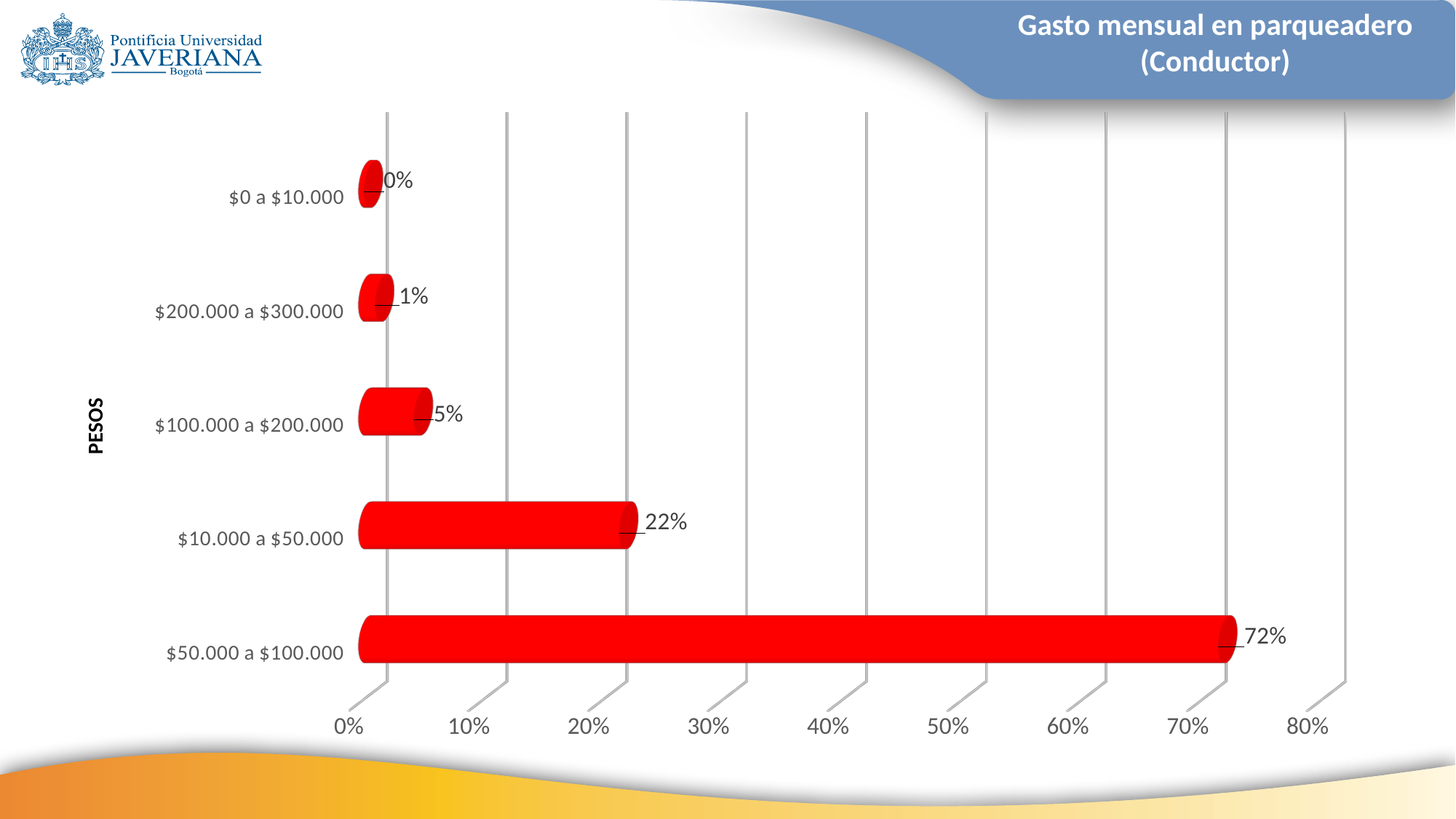
What is the difference between the values for $50.000 a $100.000 and $10.000 a $50.000? 50% Which category has the lowest value? $0 a $10.000 What is the value for $200.000 a $300.000? 1% What is the value for $100.000 a $200.000? 5% How many categories are shown in the chart? 5 Which category has the highest value? $50.000 a $100.000 Which is larger, the value for $100.000 a $200.000 or the value for $200.000 a $300.000? $100.000 a $200.000 What is the title of the chart? Gasto mensual en parqueadero (Conductor) What is the value for $10.000 a $50.000? 22% What kind of chart is shown on the slide? Bar chart What is the value for $50.000 a $100.000? 72% What is the value for $0 a $10.000? 0%